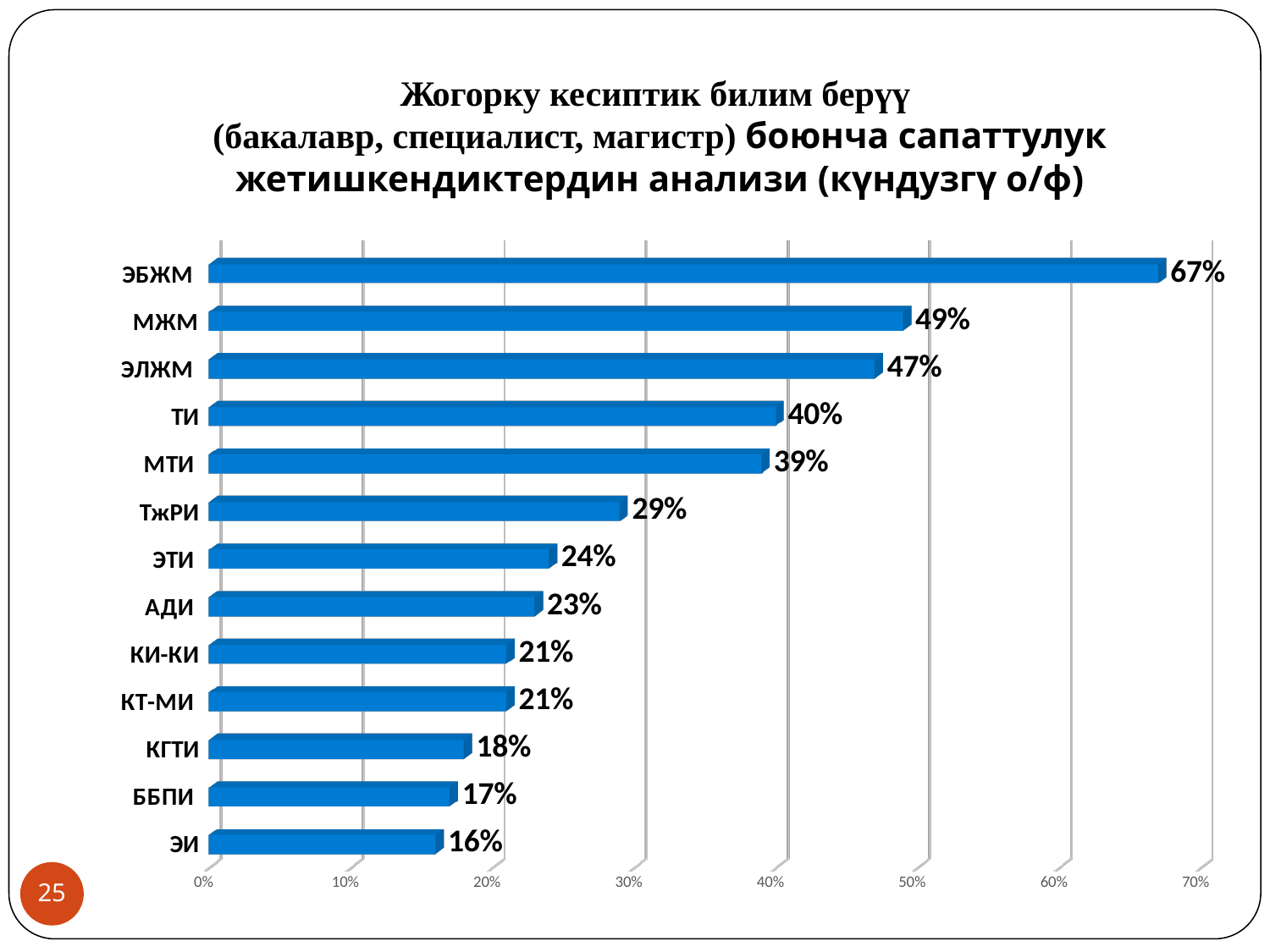
How many categories are shown in the chart? 13 What is the difference between the values for ТИ and КГТИ? 22% What is the value for МТИ? 39% What is the value for ББПИ? 17% What colour are the bars in the chart? blue What kind of chart is shown on the slide? bar chart What is the difference between the values for ЭБЖМ and МЖМ? 18% What is the value for ЭБЖМ? 67% Which category has the highest value? ЭБЖМ Is the value for ЭЛЖМ greater or less than 40%? greater Which category has the lowest value? ЭИ Which is larger, the value for ТжРИ or the value for ЭТИ? ТжРИ